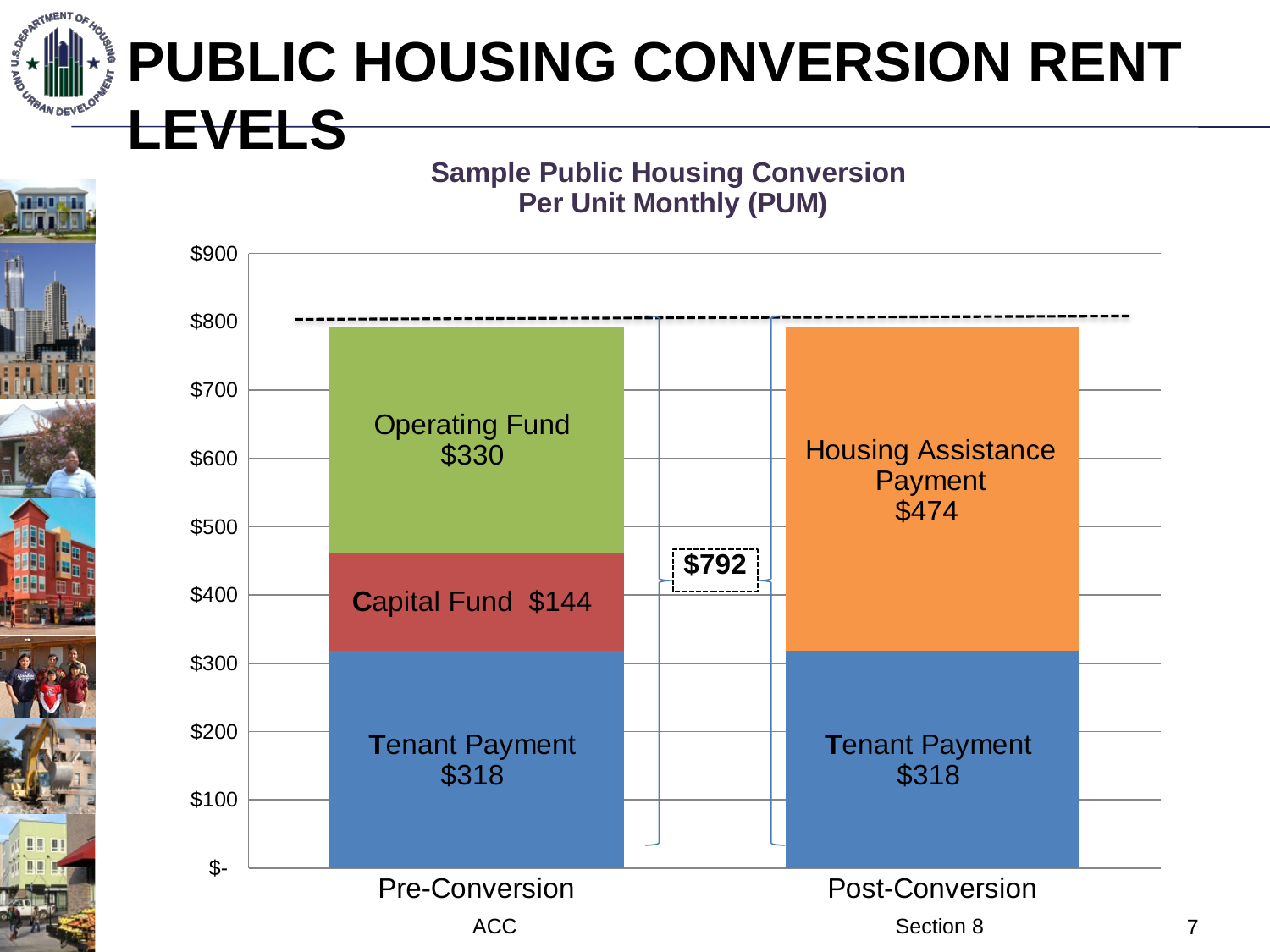
Which is larger, the Operating Fund in the Pre-Conversion bar or the Housing Assistance Payment in the Post-Conversion bar? Housing Assistance Payment What is the title of the chart? Sample Public Housing Conversion Per Unit Monthly (PUM) How many categories are shown on the x axis? 2 Which segment in the Pre-Conversion bar is the smallest? Capital Fund What is the value of the Operating Fund segment in the Pre-Conversion bar? $330 What is the total of the Pre-Conversion stacked bar? $792 What is the difference between the Housing Assistance Payment ($474) and the Operating Fund ($330)? $144 What is the Tenant Payment value in the Post-Conversion bar? $318 What kind of chart is shown on the slide? Stacked bar chart What is the total of the Post-Conversion stacked bar? $792 What is the value of the Capital Fund segment in the Pre-Conversion bar? $144 What is the value of the Housing Assistance Payment segment in the Post-Conversion bar? $474